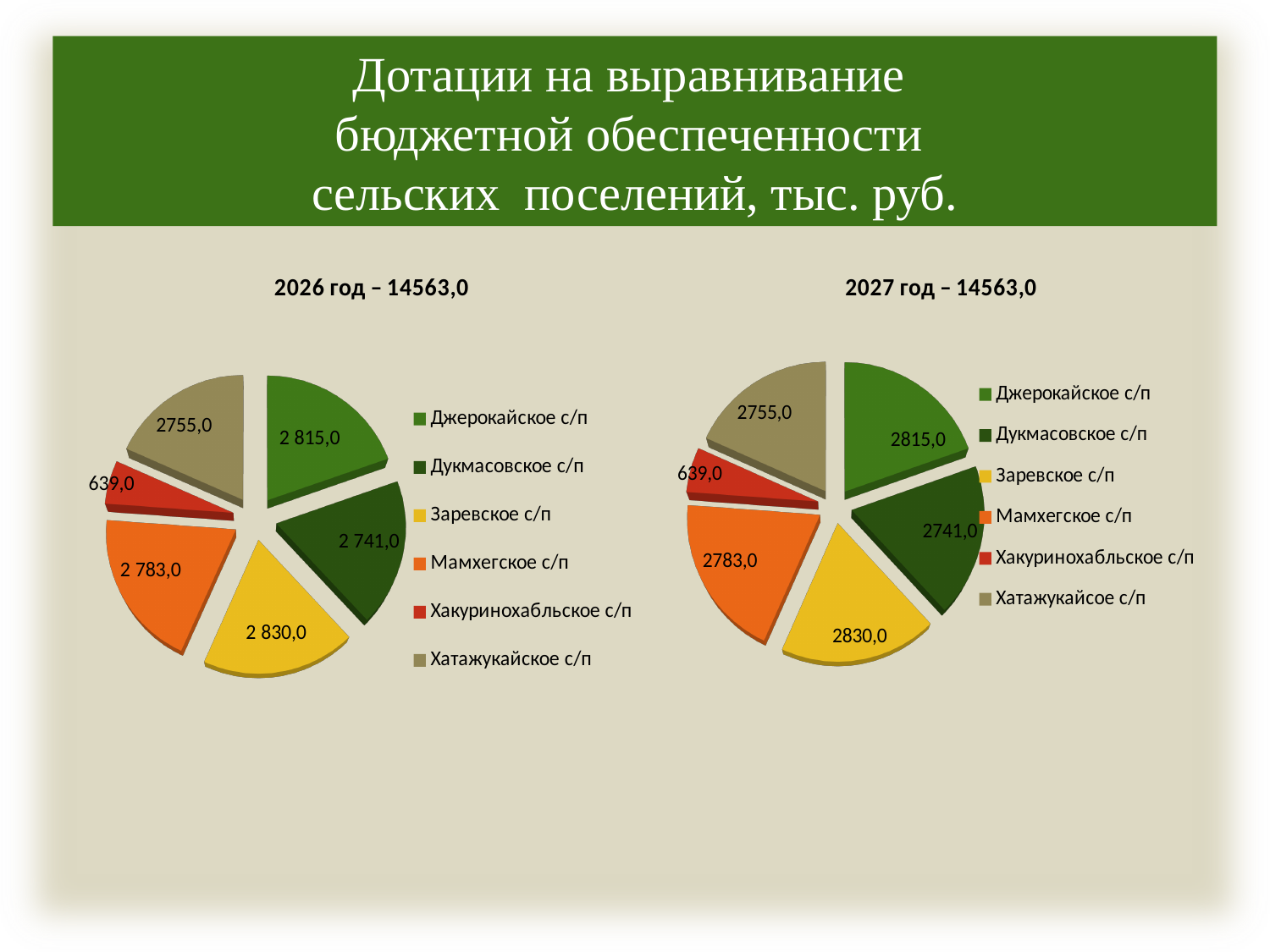
In the 2026 chart, what is the value for Хакуринохабльское с/п? 639,0 In the 2026 chart, which settlement has the smallest slice? Хакуринохабльское с/п In the 2027 chart, which settlement has the largest value? Заревское с/п In the 2027 chart, which is larger: Мамхегское с/п or Дукмасовское с/п? Мамхегское с/п In the 2027 chart, what is the value for Мамхегское с/п? 2783,0 In the 2027 chart, what is the value for Хатажукайсое с/п? 2755,0 In the 2027 chart legend, which colour represents Заревское с/п? Yellow In the 2026 chart, what is the difference between the values for Заревское с/п and Джерокайское с/п? 15,0 What total is shown in the heading above the 2026 chart? 14563,0 What type of chart is used for the 2027 data? Pie chart How many slices does the 2026 pie chart have? 6 In the 2026 chart, what is the value for Джерокайское с/п? 2 815,0